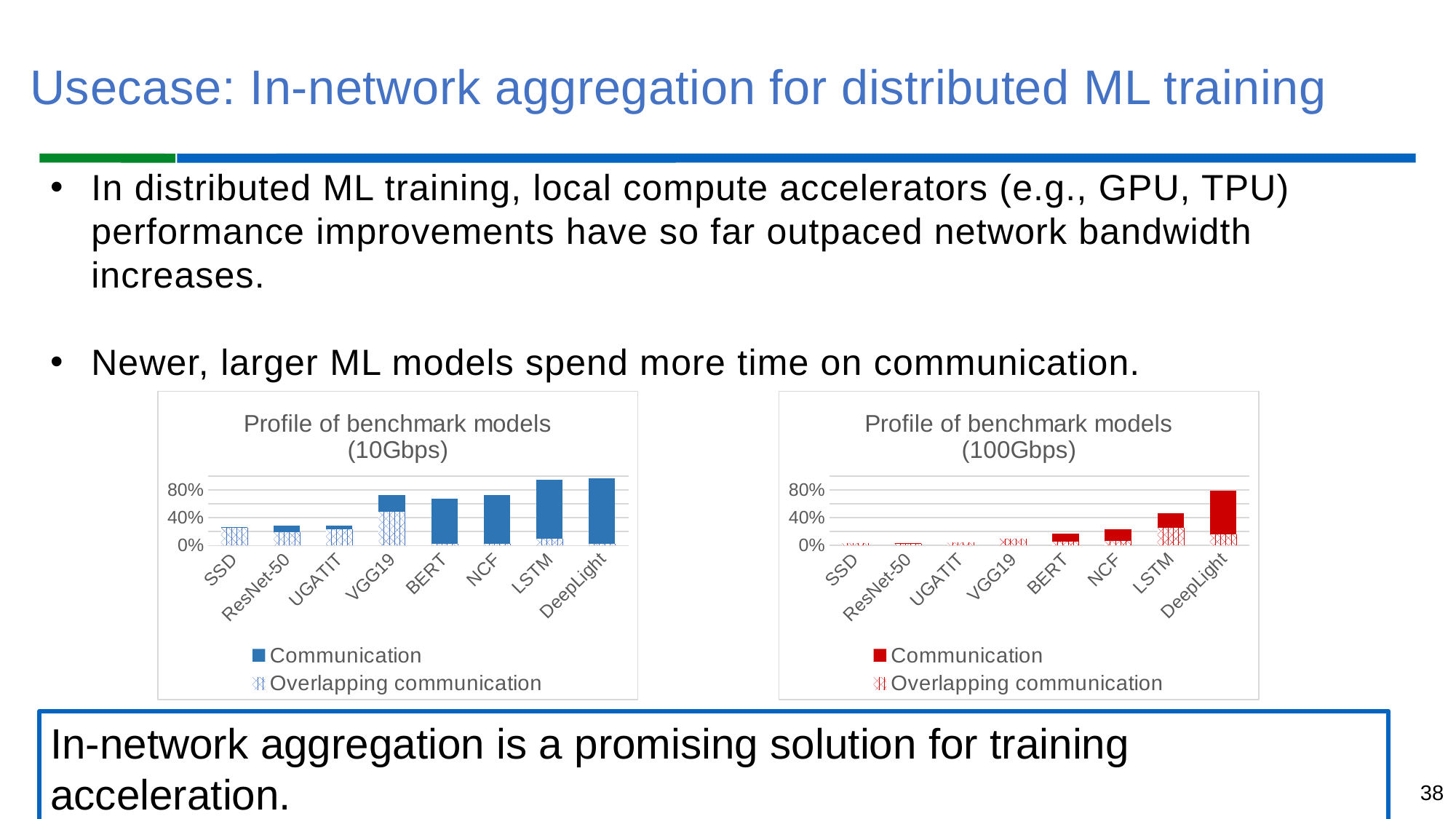
In the 'Profile of benchmark models (10Gbps)' chart, which is larger, the value for LSTM or the value for SSD? LSTM In the 'Profile of benchmark models (10Gbps)' chart, is the value for VGG19 greater or less than 40%? greater In the 'Profile of benchmark models (10Gbps)' chart, is the value for SSD greater or less than 40%? less How many benchmark models are shown on the x axis of the 'Profile of benchmark models (100Gbps)' chart? 8 In the 'Profile of benchmark models (10Gbps)' chart, is the value for LSTM greater or less than 80%? greater What kind of chart is the 'Profile of benchmark models (10Gbps)' chart? bar chart In the 'Profile of benchmark models (100Gbps)' chart, which is larger, the value for DeepLight or the value for LSTM? DeepLight How many series does the legend of the 'Profile of benchmark models (10Gbps)' chart list? 2 In the 'Profile of benchmark models (100Gbps)' chart, do the values generally rise or fall from SSD to DeepLight along the x axis? rise In the 'Profile of benchmark models (100Gbps)' chart, which model has the highest communication share? DeepLight